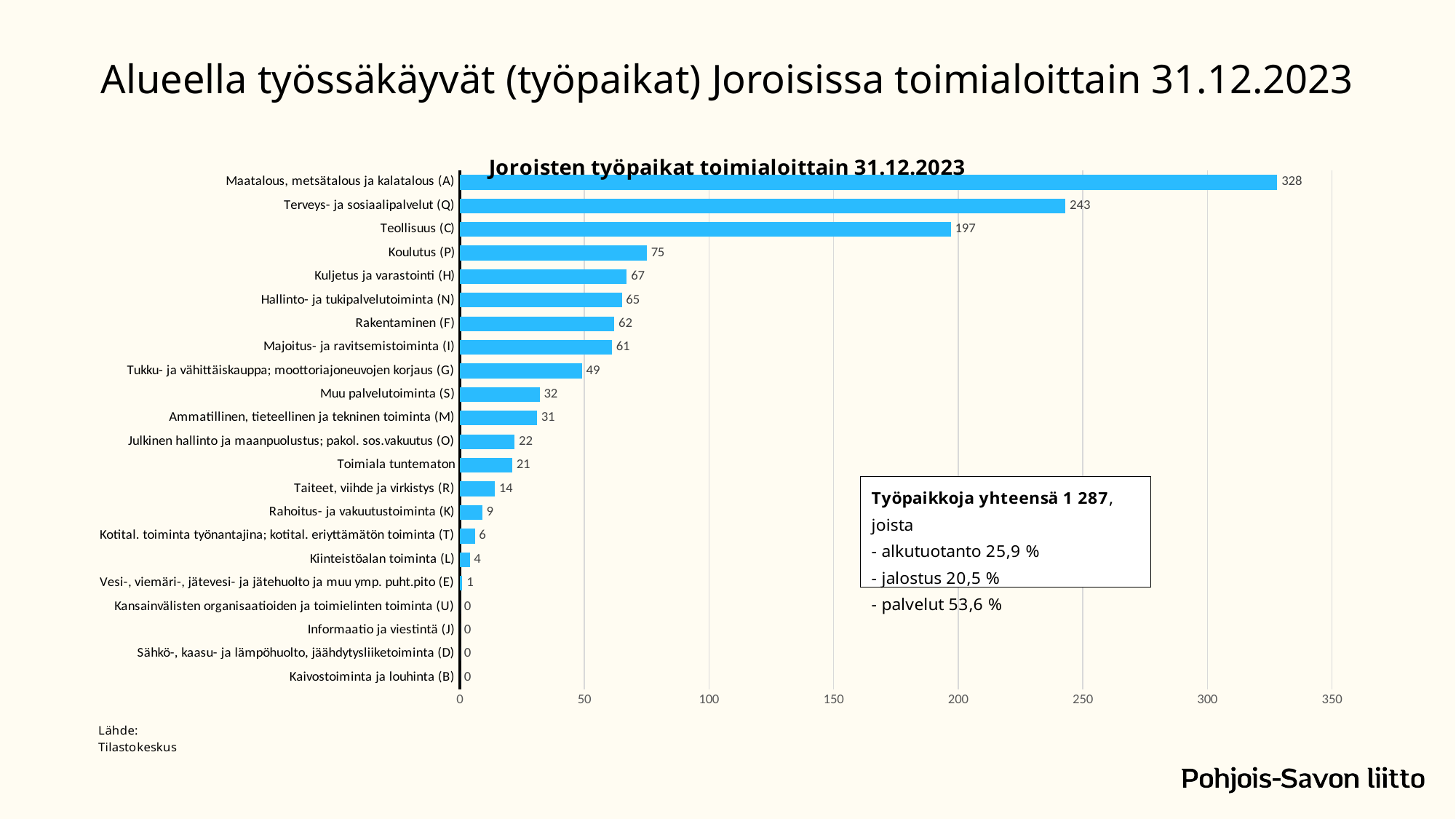
What is the value for Maatalous, metsätalous ja kalatalous (A)? 328 What is the title of the chart? Joroisten työpaikat toimialoittain 31.12.2023 What is the difference between Koulutus (P) and Rakentaminen (F)? 13 Which category has the highest value? Maatalous, metsätalous ja kalatalous (A) What is the value for Taiteet, viihde ja virkistys (R)? 14 What is the value for Kuljetus ja varastointi (H)? 67 What is the value for Teollisuus (C)? 197 What is the difference between Terveys- ja sosiaalipalvelut (Q) and Teollisuus (C)? 46 What kind of chart is shown on the slide? Bar chart How many categories have a value of 0? 4 Which is larger, Muu palvelutoiminta (S) or Tukku- ja vähittäiskauppa; moottoriajoneuvojen korjaus (G)? Tukku- ja vähittäiskauppa; moottoriajoneuvojen korjaus (G) How many categories are shown in the chart? 22